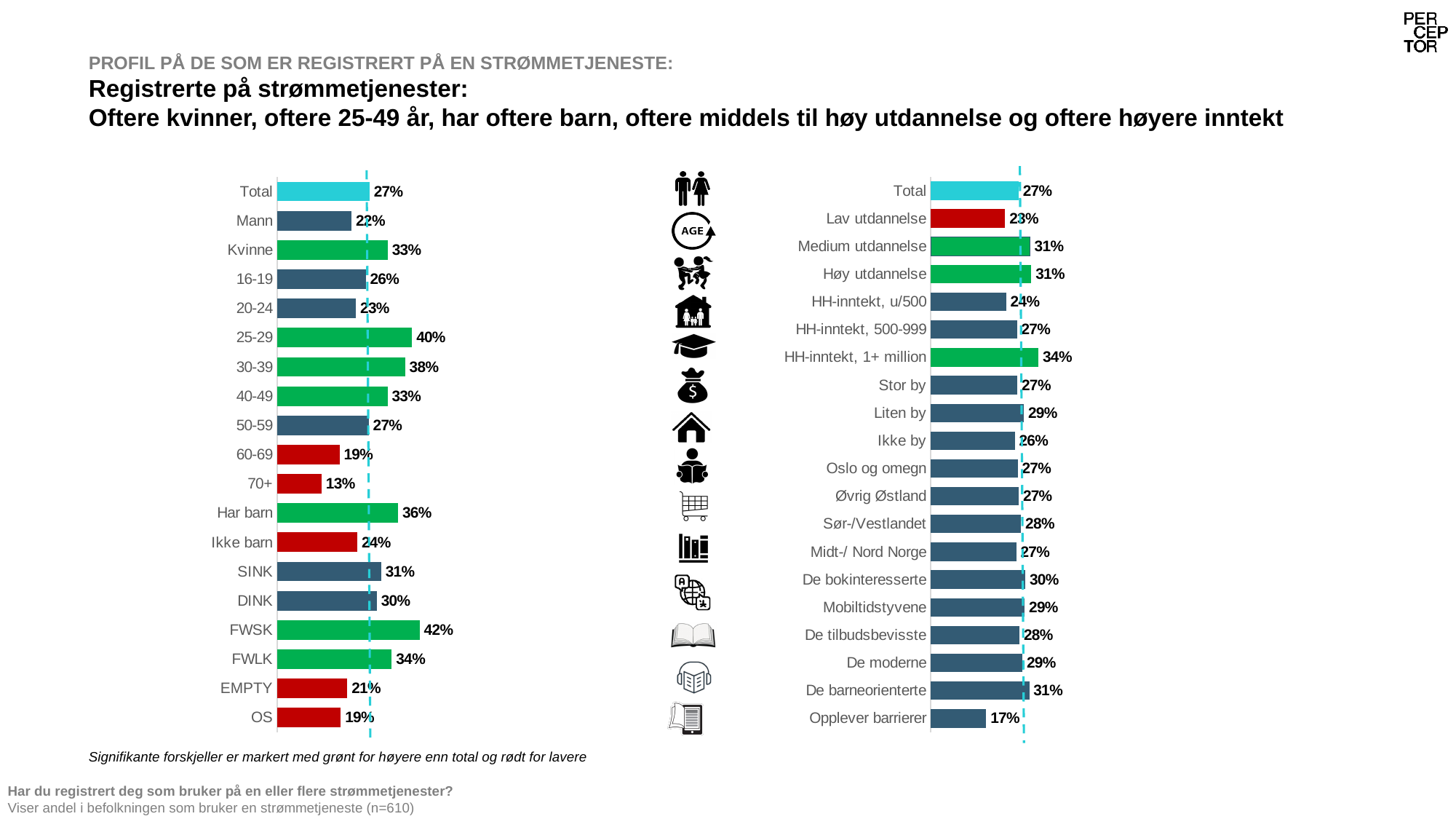
In the right chart, what is the difference between Høy utdannelse and Lav utdannelse? 8 percentage points What type of chart is the left chart? Bar chart In the right chart, what is the value for HH-inntekt, 1+ million? 34% In the left chart, what is the value for 25-29? 40% In the left chart, what is the difference between Har barn and Ikke barn? 12 percentage points In the left chart, which category has the lowest value? 70+ In the left chart, which category has the highest value? FWSK In the right chart, what is the value for Opplever barrierer? 17% In the left chart, what is the value for Kvinne? 33% In the left chart, which is larger, Mann or Kvinne? Kvinne In the right chart, which category has the lowest value? Opplever barrierer How many categories are shown in the right chart? 20